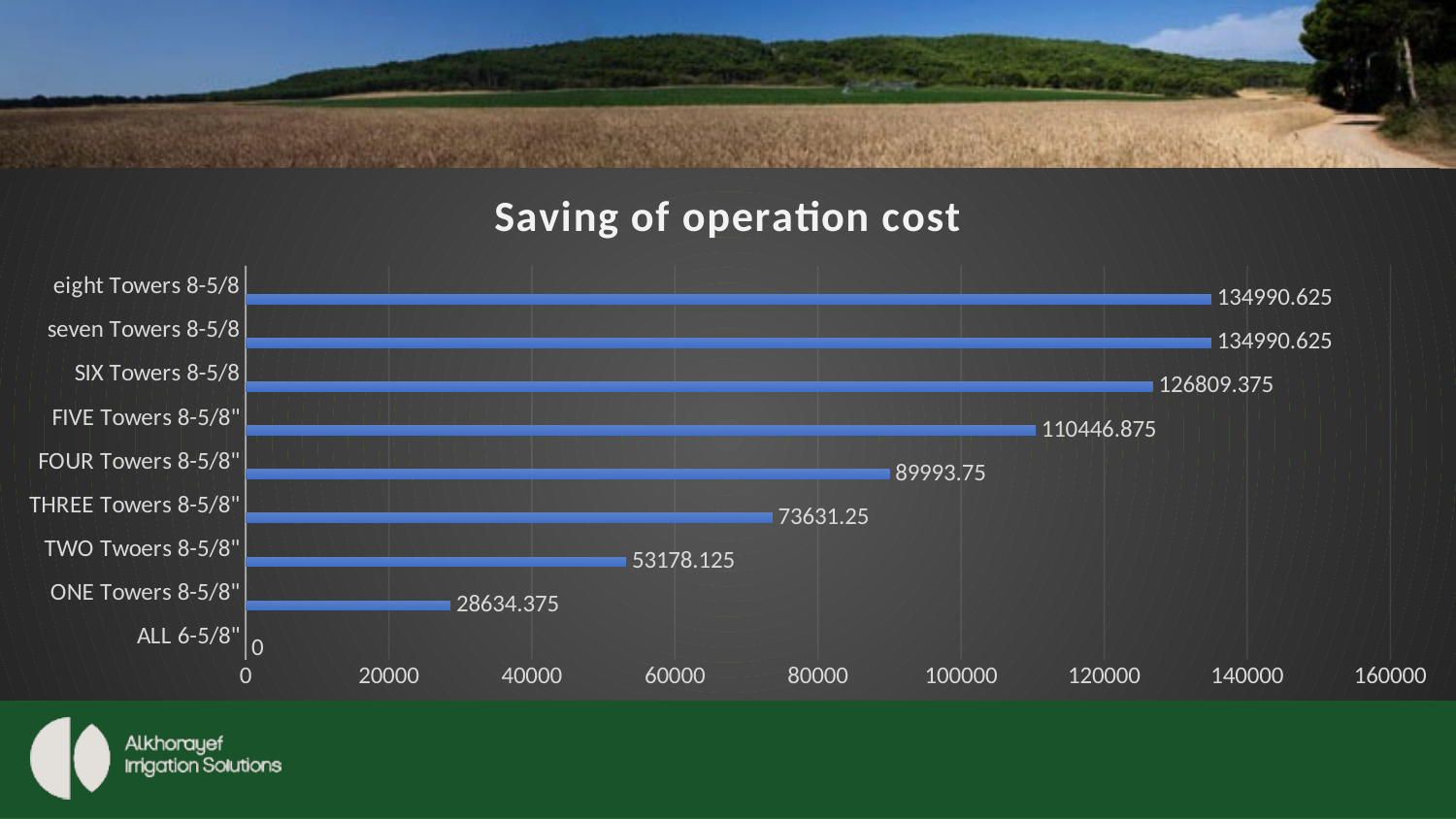
How many categories are shown on the chart? 9 What value is shown for TWO Twoers 8-5/8"? 53178.125 What is the value for SIX Towers 8-5/8? 126809.375 Is the value for FOUR Towers 8-5/8" greater or less than 100000? less What is the difference between the values for TWO Twoers 8-5/8" and ONE Towers 8-5/8"? 24543.75 What is the title of the chart? Saving of operation cost What is the value for ONE Towers 8-5/8"? 28634.375 Which category has the lowest saving of operation cost? ALL 6-5/8" What is the saving of operation cost for FIVE Towers 8-5/8"? 110446.875 Which is larger, the value for THREE Towers 8-5/8" or the value for FOUR Towers 8-5/8"? FOUR Towers 8-5/8" What kind of chart is shown on the slide? bar chart What is the difference between the values for FIVE Towers 8-5/8" and FOUR Towers 8-5/8"? 20453.125